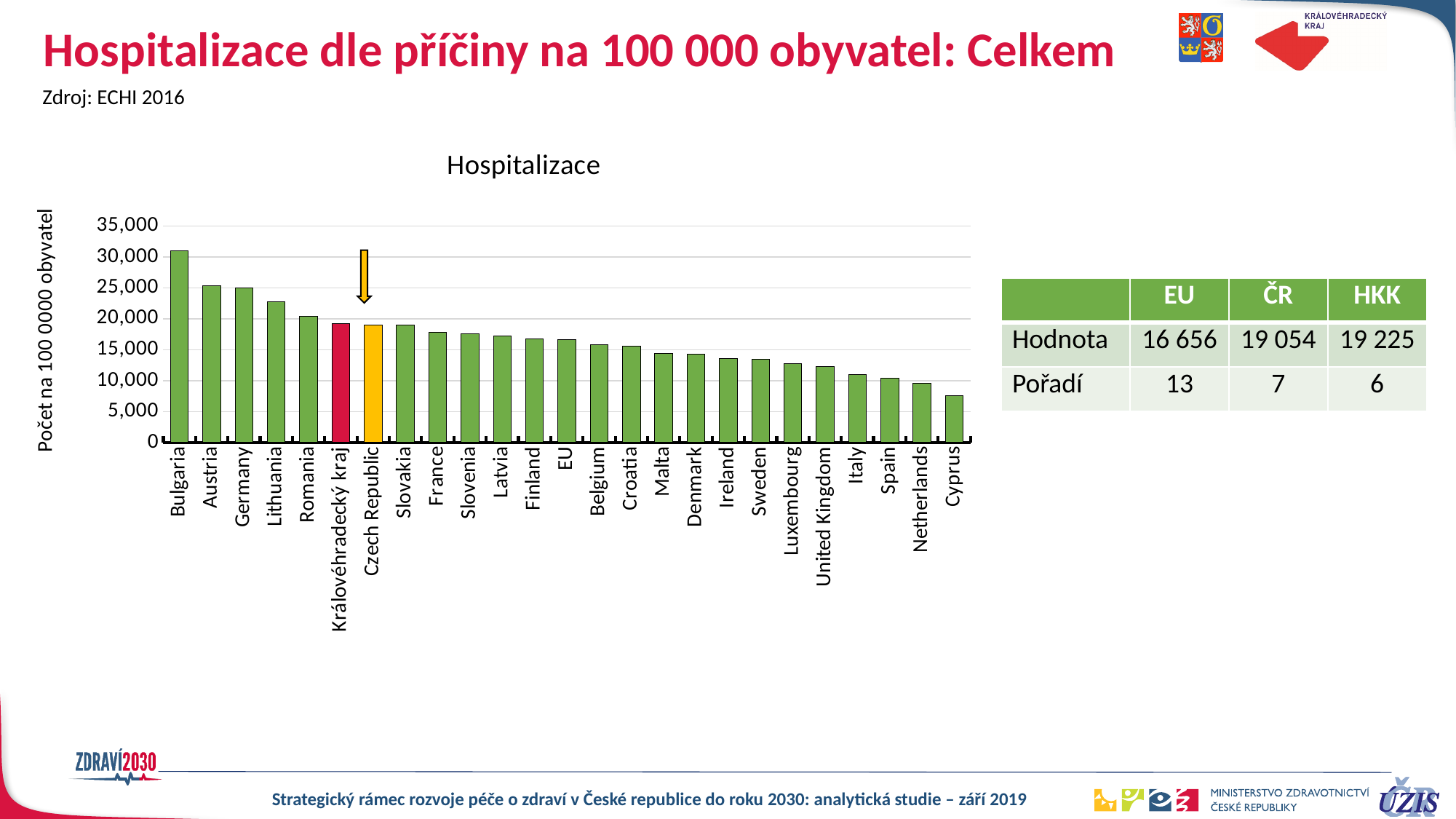
What is the rank (Pořadí) of ČR in the table? 7 Is the value for Cyprus greater or less than 10,000? less Which country or region has the highest hospitalization rate in the chart? Bulgaria How many categories (countries/regions) are plotted in the chart? 25 According to the table, what is the hospitalization value (Hodnota) for the EU? 16 656 According to the table, what is the hospitalization value (Hodnota) for HKK? 19 225 Which country has the lowest hospitalization rate in the chart? Cyprus What is the difference between the HKK value and the ČR value in the table? 171 What colour is the bar for Czech Republic? yellow Which has the larger value, HKK or ČR? HKK What type of chart is shown on the slide? bar chart Do the values rise or fall from left to right along the x axis? fall